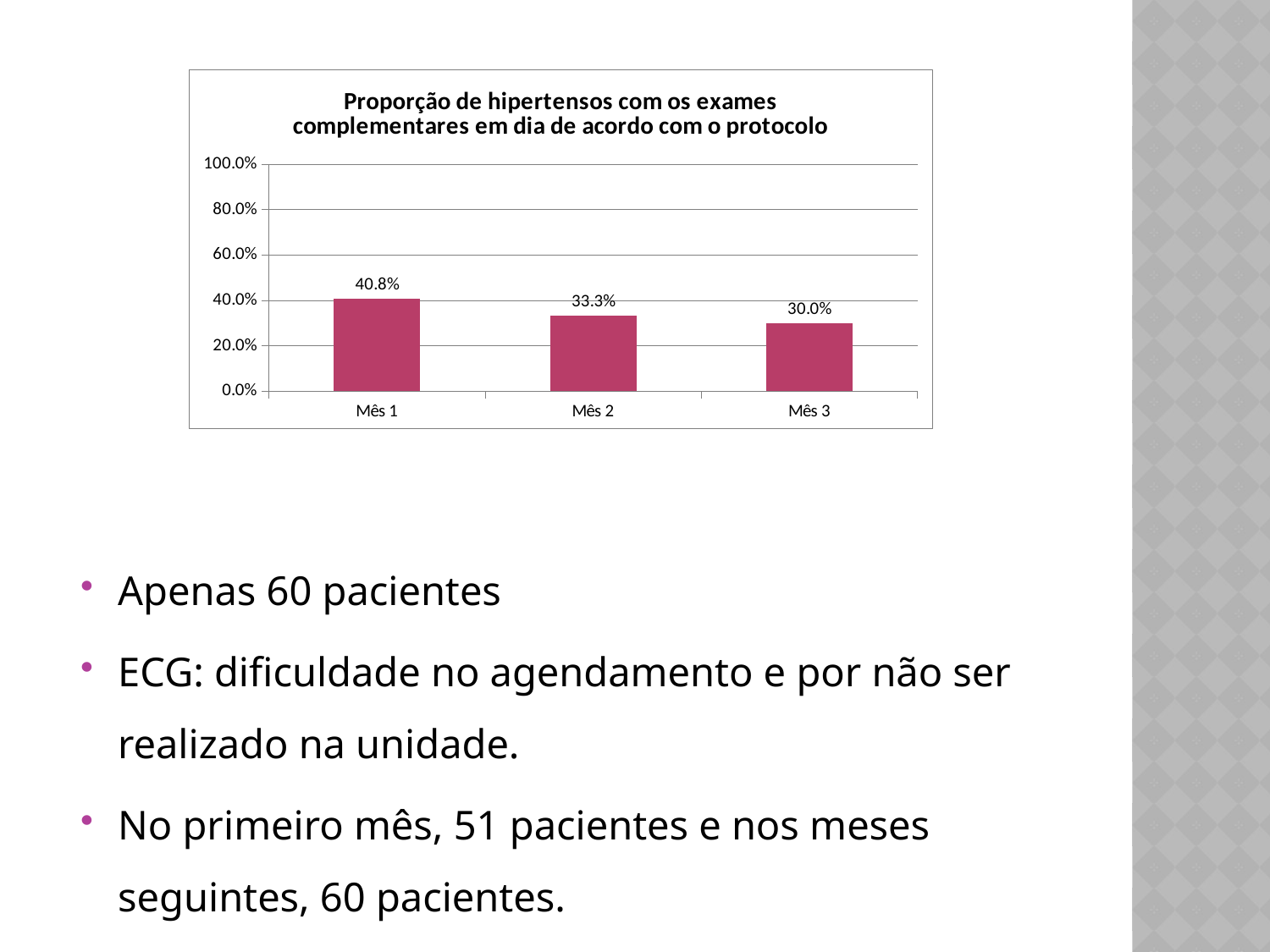
What is the value for Mês 3? 30.0% What is the value for Mês 2? 33.3% What kind of chart is shown? bar chart What is the difference between the values for Mês 1 and Mês 3? 10.8% Which is larger, the value for Mês 2 or the value for Mês 3? Mês 2 What is the difference between the values for Mês 1 and Mês 2? 7.5% Do the values rise or fall from Mês 1 to Mês 3? fall Which month has the lowest value? Mês 3 How many months are shown on the x axis? 3 Is the value for Mês 1 greater or less than 60.0%? less Which month has the highest value? Mês 1 What is the value for Mês 1? 40.8%